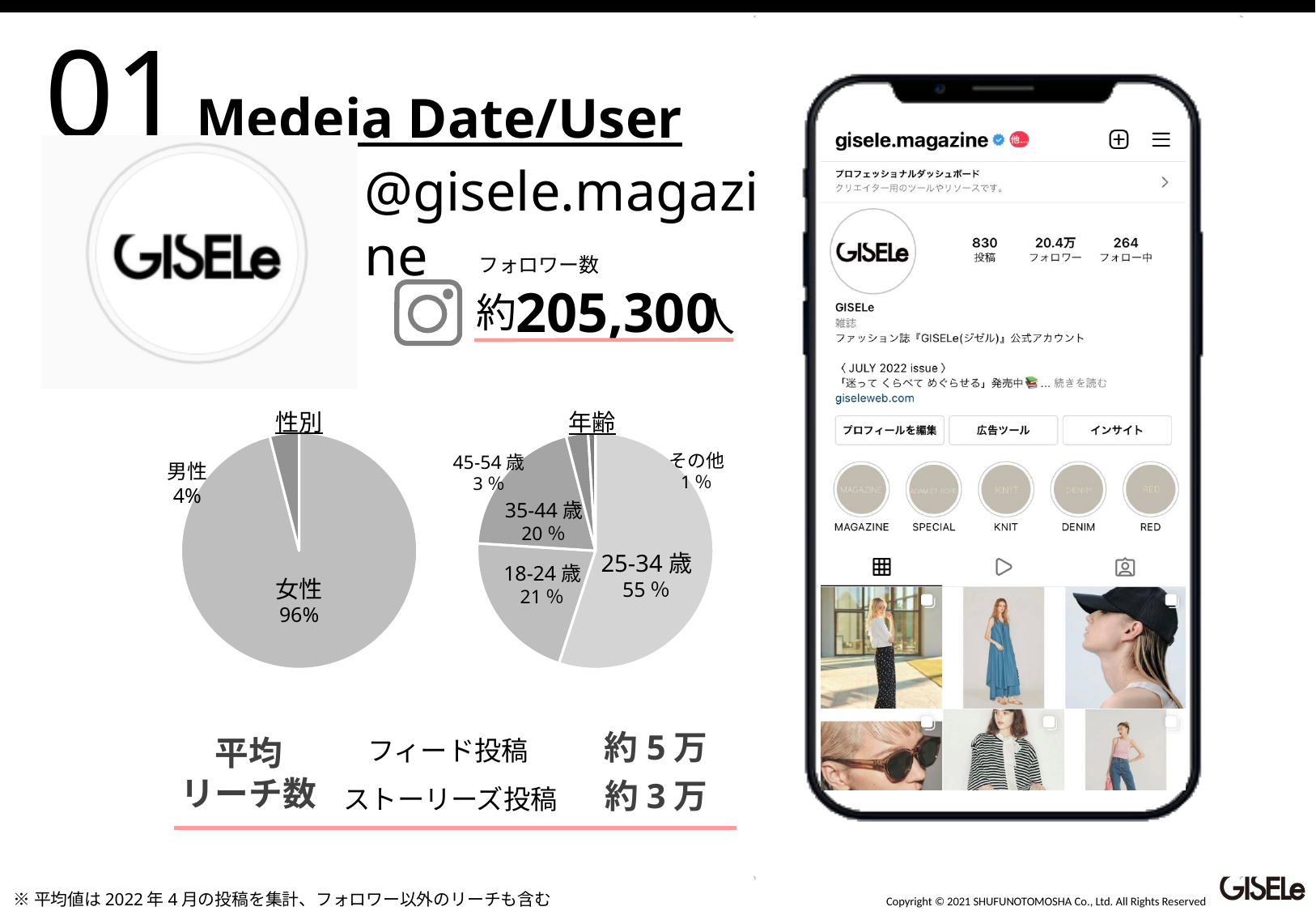
In the 性別 pie chart, which slice is the largest? 女性 What kind of chart is the 性別 chart? pie chart In the 性別 pie chart, what share is 女性? 96% In the 年齢 pie chart, which is larger, 45-54 歳 or 35-44 歳? 35-44 歳 In the 年齢 pie chart, which slice is the smallest? その他 In the 年齢 pie chart, what share is 35-44 歳? 20 % In the 年齢 pie chart, what share is 25-34 歳? 55 % How many slices does the 年齢 pie chart have? 5 In the 性別 pie chart, what share is 男性? 4% In the 年齢 pie chart, what is the difference between 25-34 歳 and 18-24 歳? 34 % In the 年齢 pie chart, which slice is the largest? 25-34 歳 In the 性別 pie chart, what is the difference between 女性 and 男性? 92%